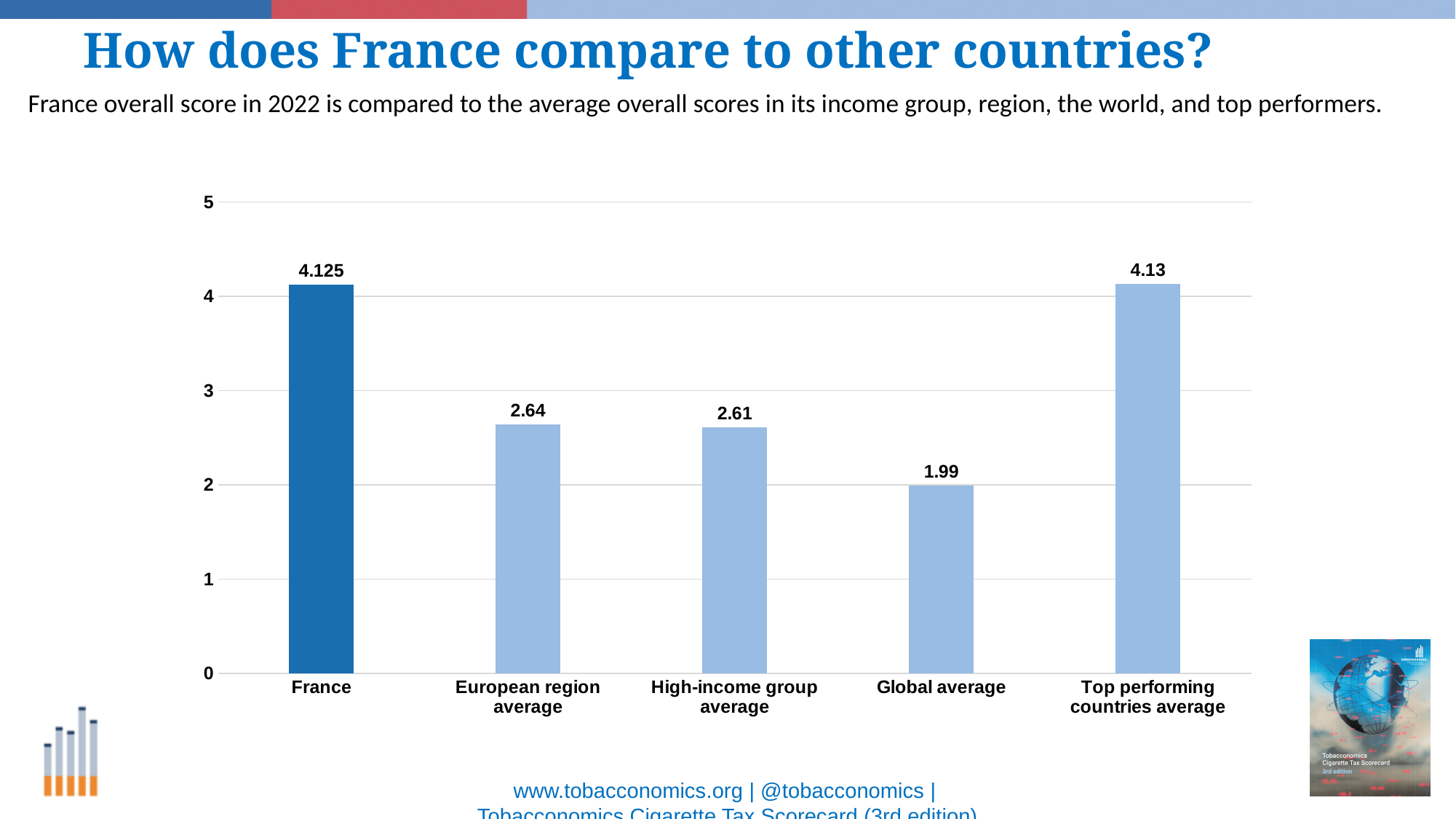
What is the value for the European region average? 2.64 What is the value for the Global average? 1.99 Which category has the lowest value? Global average Which is larger, the value for France or the European region average? France Which bar is shown in a darker blue than the others? France What is the value for the Top performing countries average? 4.13 What kind of chart is shown on the slide? Bar chart What is the difference between the value for France and the Global average? 2.135 How many categories are shown on the chart? 5 What is the value for France? 4.125 What is the difference between the Top performing countries average and the Global average? 2.14 What is the value for the High-income group average? 2.61